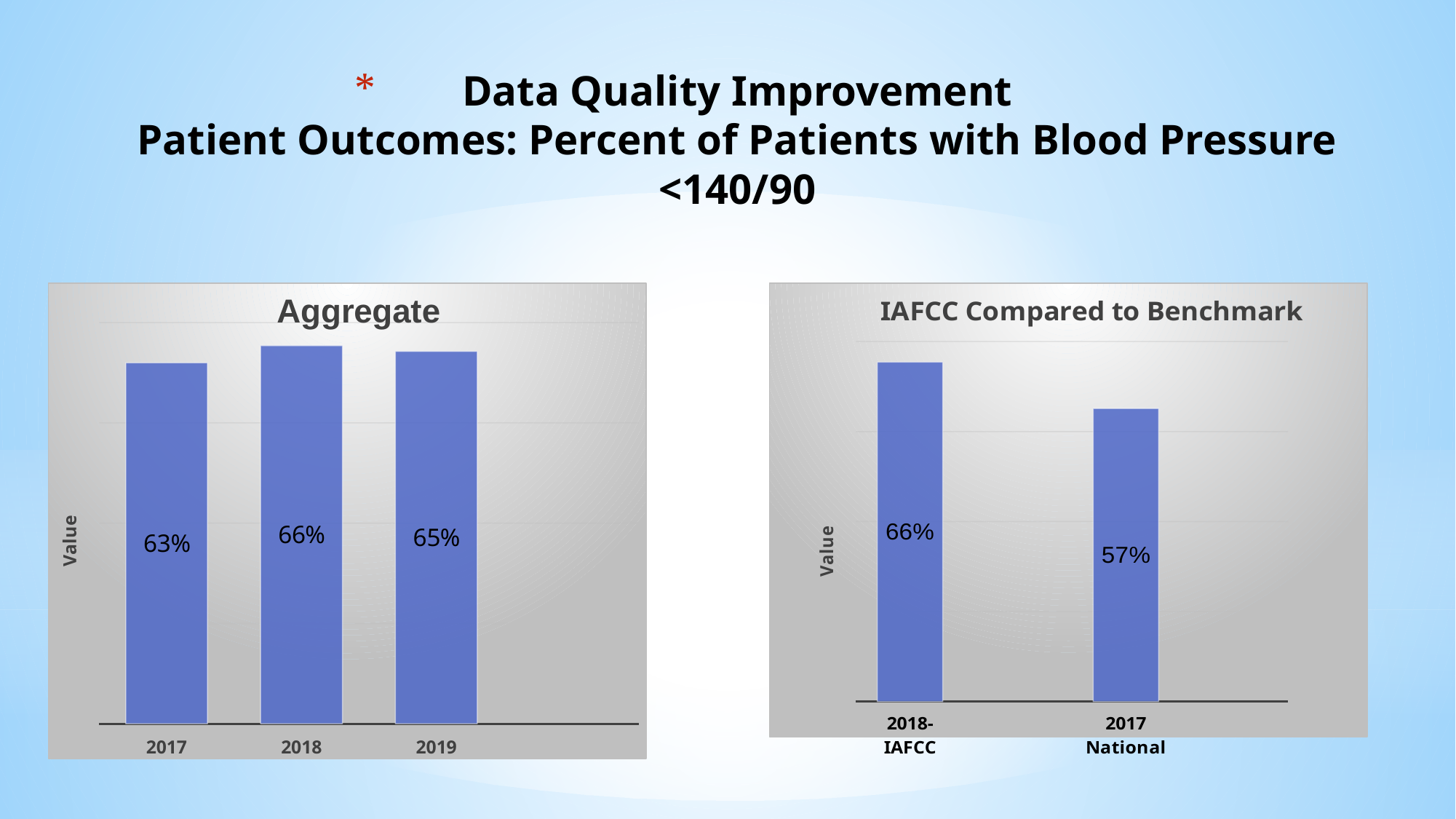
In the Aggregate chart, what is the value for 2018? 66% In the Aggregate chart, what is the value for 2017? 63% In the Aggregate chart, how many years are shown? 3 In the IAFCC Compared to Benchmark chart, what is the value for 2017 National? 57% In the Aggregate chart, which year has the highest value? 2018 In the IAFCC Compared to Benchmark chart, which is larger, 2018-IAFCC or 2017 National? 2018-IAFCC In the Aggregate chart, what is the difference between the 2018 and 2017 values? 3% In the IAFCC Compared to Benchmark chart, what is the value for 2018-IAFCC? 66% In the Aggregate chart, what is the value for 2019? 65% What type of chart is the Aggregate chart? Bar chart In the IAFCC Compared to Benchmark chart, what is the difference between the 2018-IAFCC and 2017 National values? 9% In the Aggregate chart, which year has the lowest value? 2017